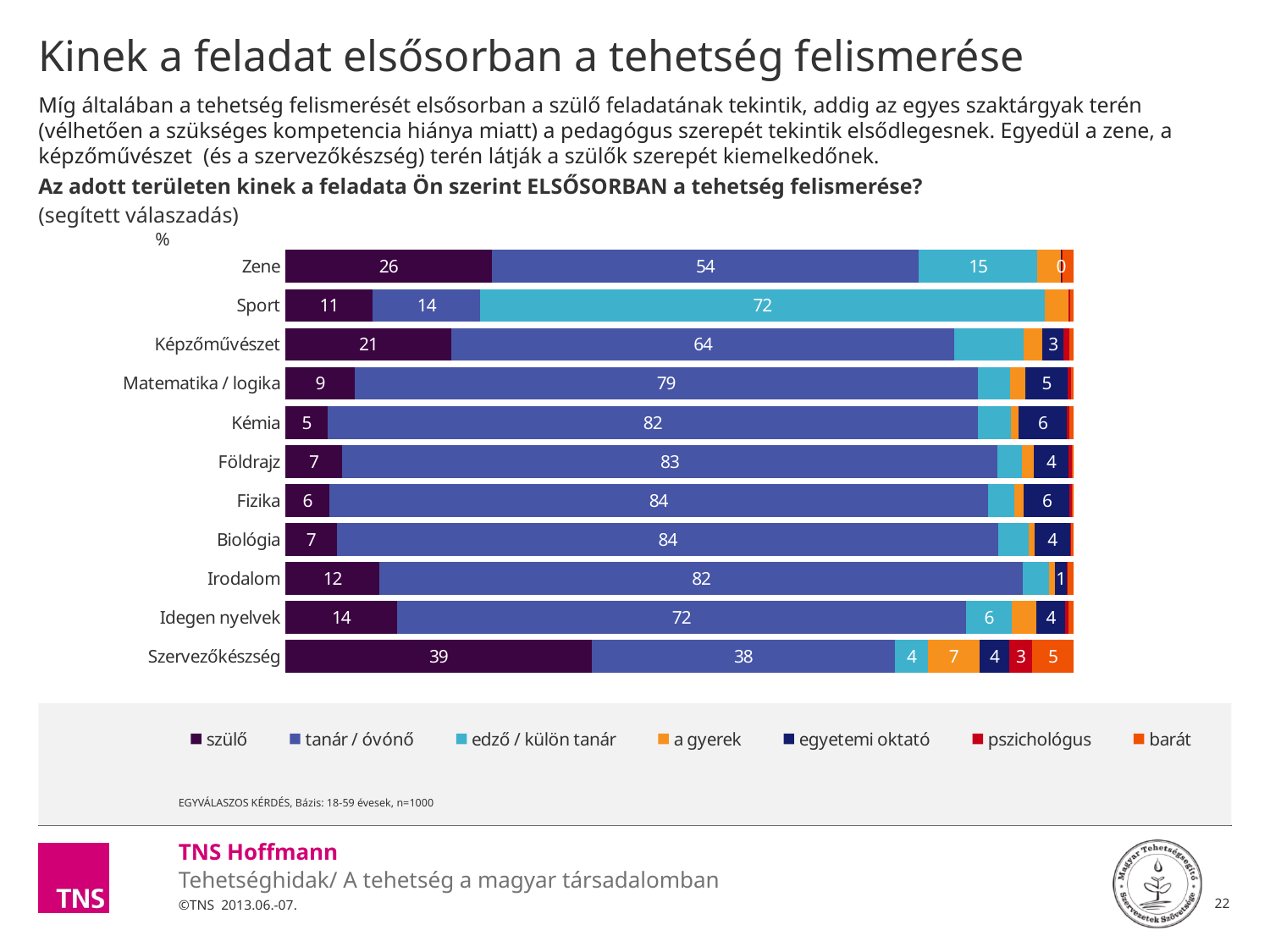
What is the value for egyetemi oktató in the Idegen nyelvek bar? 4 Which category has the lowest value for szülő? Kémia What is the value for edző / külön tanár in the Sport bar? 72 Which has the larger tanár / óvónő value, Fizika or Matematika / logika? Fizika What is the value for szülő in the Szervezőkészség bar? 39 What is the value for tanár / óvónő in the Kémia bar? 82 How many series does the legend list? 7 In the Zene bar, what is the difference between the tanár / óvónő value and the szülő value? 28 How many categories are shown on the chart? 11 What kind of chart is shown on the slide? Stacked bar chart What is the total of the Szervezőkészség bar? 100 Which category has the highest value for szülő? Szervezőkészség